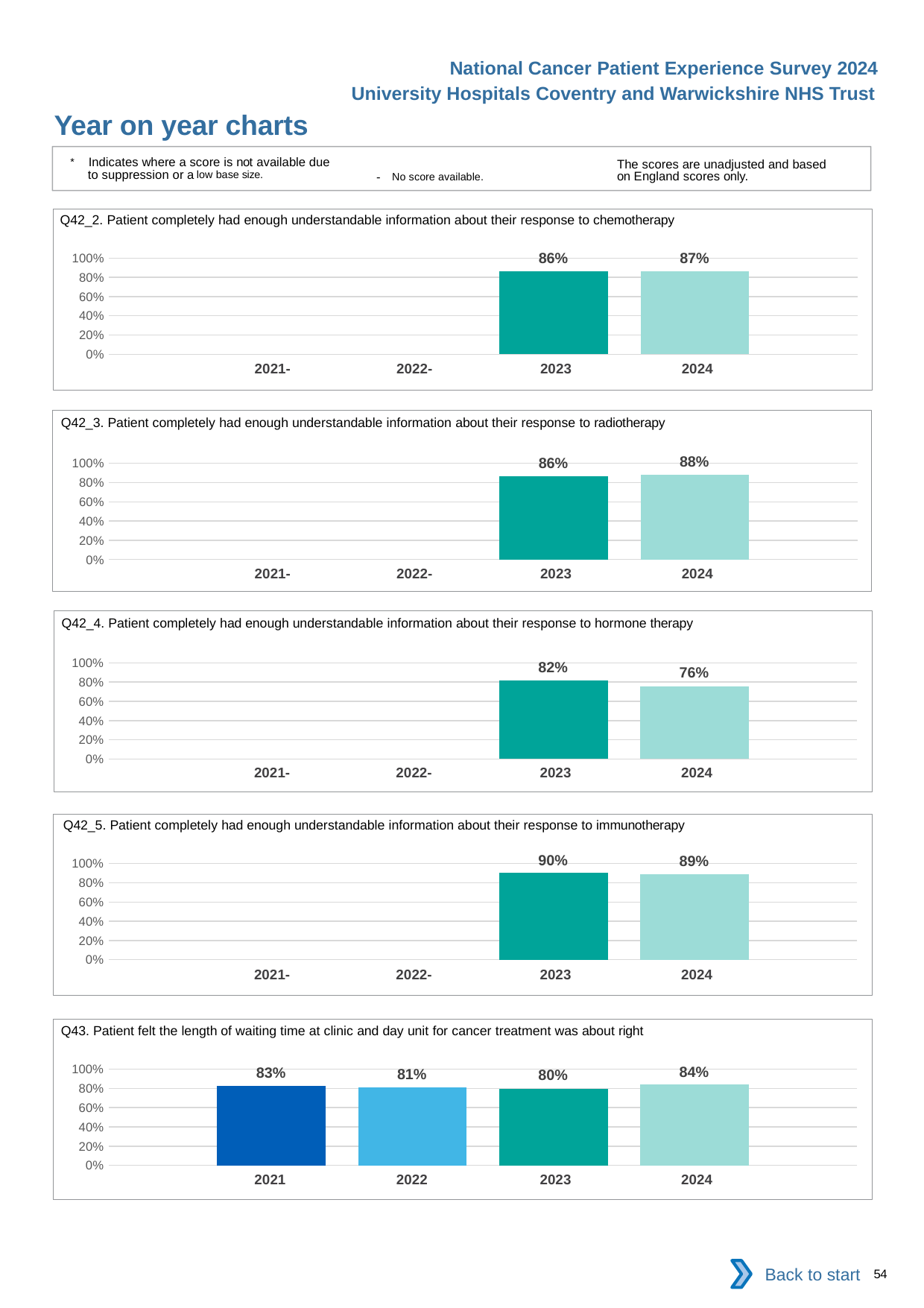
In the Q42_4 chart (hormone therapy), which year has the higher value, 2023 or 2024? 2023 What type of chart is the Q43 chart? Bar chart In the Q42_4 chart (hormone therapy), what is the difference between the 2023 and 2024 values? 6 percentage points In the Q42_2 chart (chemotherapy), what is the value for 2024? 87% In the Q43 chart (waiting time at clinic and day unit), which year has the lowest value? 2023 In the Q42_3 chart (radiotherapy), what is the value for 2023? 86% In the Q43 chart (waiting time at clinic and day unit), how many years have a bar plotted? 4 In the Q43 chart (waiting time at clinic and day unit), which year has the highest value? 2024 In the Q42_2 chart (chemotherapy), how many years have a bar plotted? 2 In the Q42_5 chart (immunotherapy), is the value for 2024 greater or less than 80%? greater In the Q43 chart (waiting time at clinic and day unit), what is the value for 2021? 83% In the Q42_5 chart (immunotherapy), what is the value for 2023? 90%